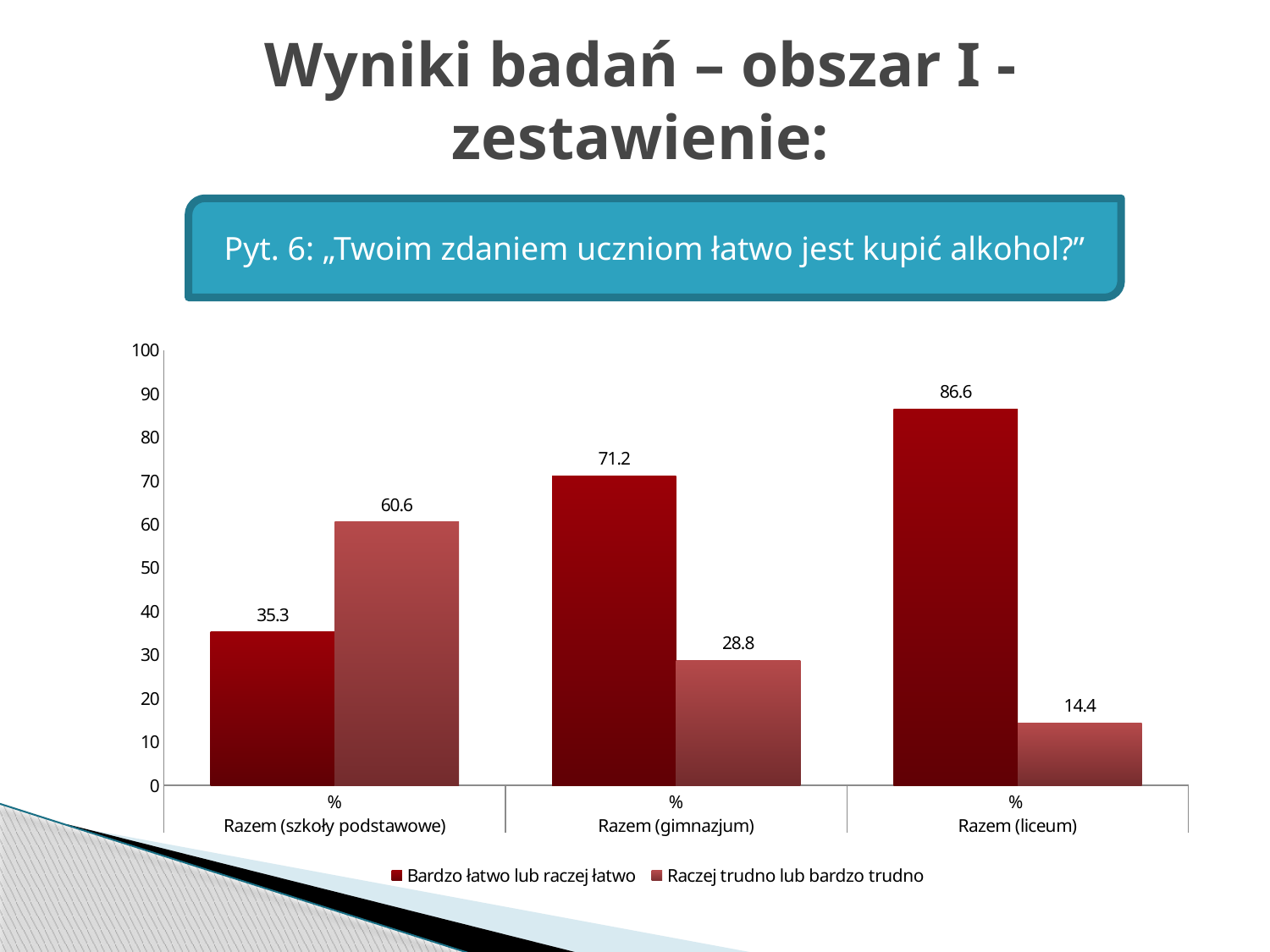
What kind of chart is shown on the slide? bar chart Which is larger in the Razem (szkoły podstawowe) group: "Bardzo łatwo lub raczej łatwo" or "Raczej trudno lub bardzo trudno"? Raczej trudno lub bardzo trudno What is the difference between the two series values in the Razem (liceum) group? 72.2 Do the values for "Bardzo łatwo lub raczej łatwo" rise or fall from left to right across the groups? rise How many series does the legend list? 2 How many groups are shown on the x axis? 3 What is the value for "Raczej trudno lub bardzo trudno" in the Razem (liceum) group? 14.4 What is the value for "Bardzo łatwo lub raczej łatwo" in the Razem (gimnazjum) group? 71.2 Which group has the lowest value for "Raczej trudno lub bardzo trudno"? Razem (liceum) What is the value for "Raczej trudno lub bardzo trudno" in the Razem (szkoły podstawowe) group? 60.6 What question is the chart about, as shown in the blue box? Pyt. 6: „Twoim zdaniem uczniom łatwo jest kupić alkohol?” Which group has the highest value for "Bardzo łatwo lub raczej łatwo"? Razem (liceum)